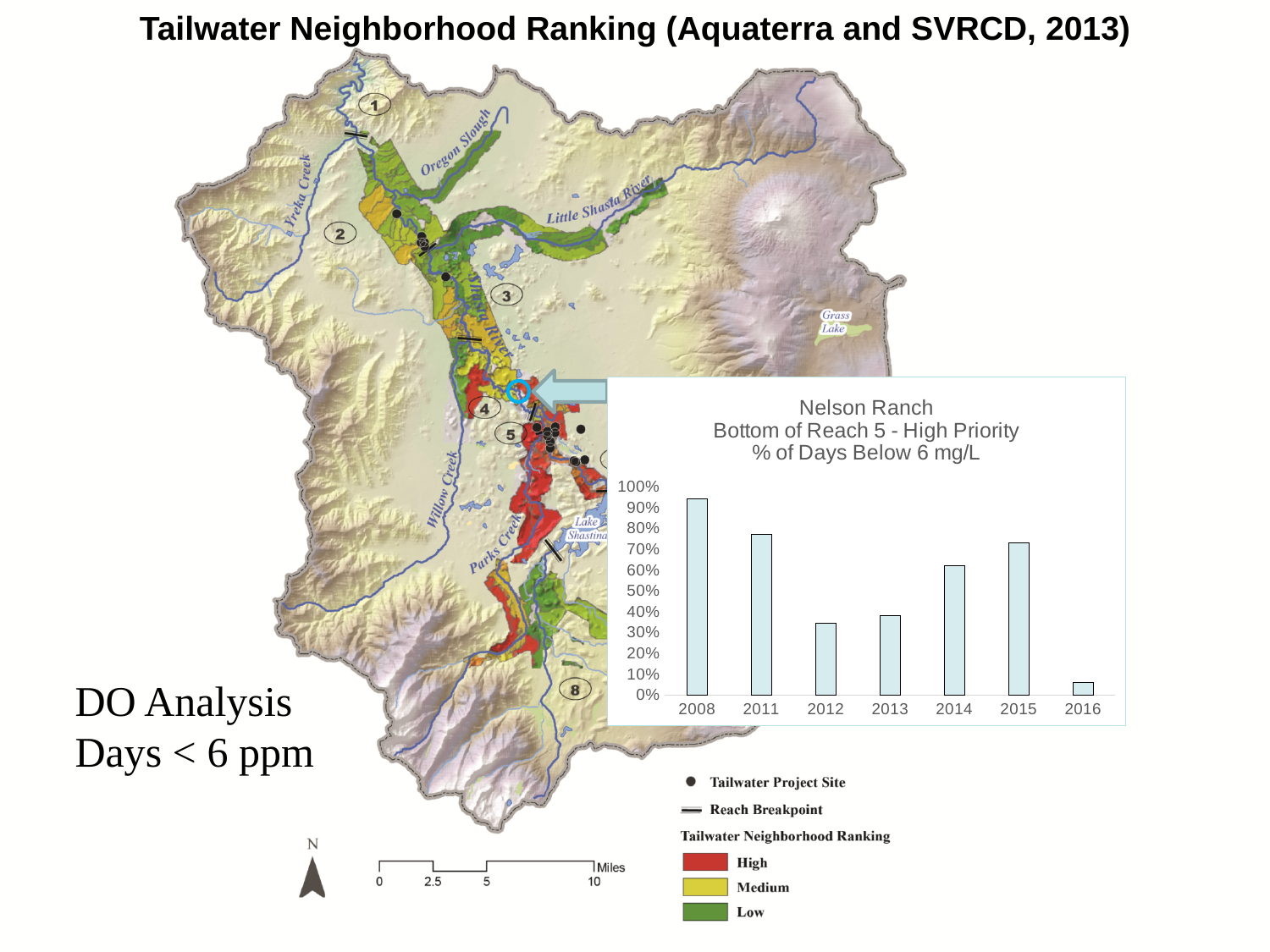
How many years are shown on the x axis of the chart? 7 Is the value for 2008 greater or less than 90%? greater What is the highest value shown on the chart's y axis? 100% Which year has a higher value, 2014 or 2015? 2015 Is the value for 2012 greater or less than 40%? less What is the first line of the chart's title? Nelson Ranch Is the value for 2016 greater or less than 10%? less Which year has a higher value, 2011 or 2012? 2011 What kind of chart is shown on the slide? bar chart Which year has the lowest % of days below 6 mg/L? 2016 Which year has the highest % of days below 6 mg/L? 2008